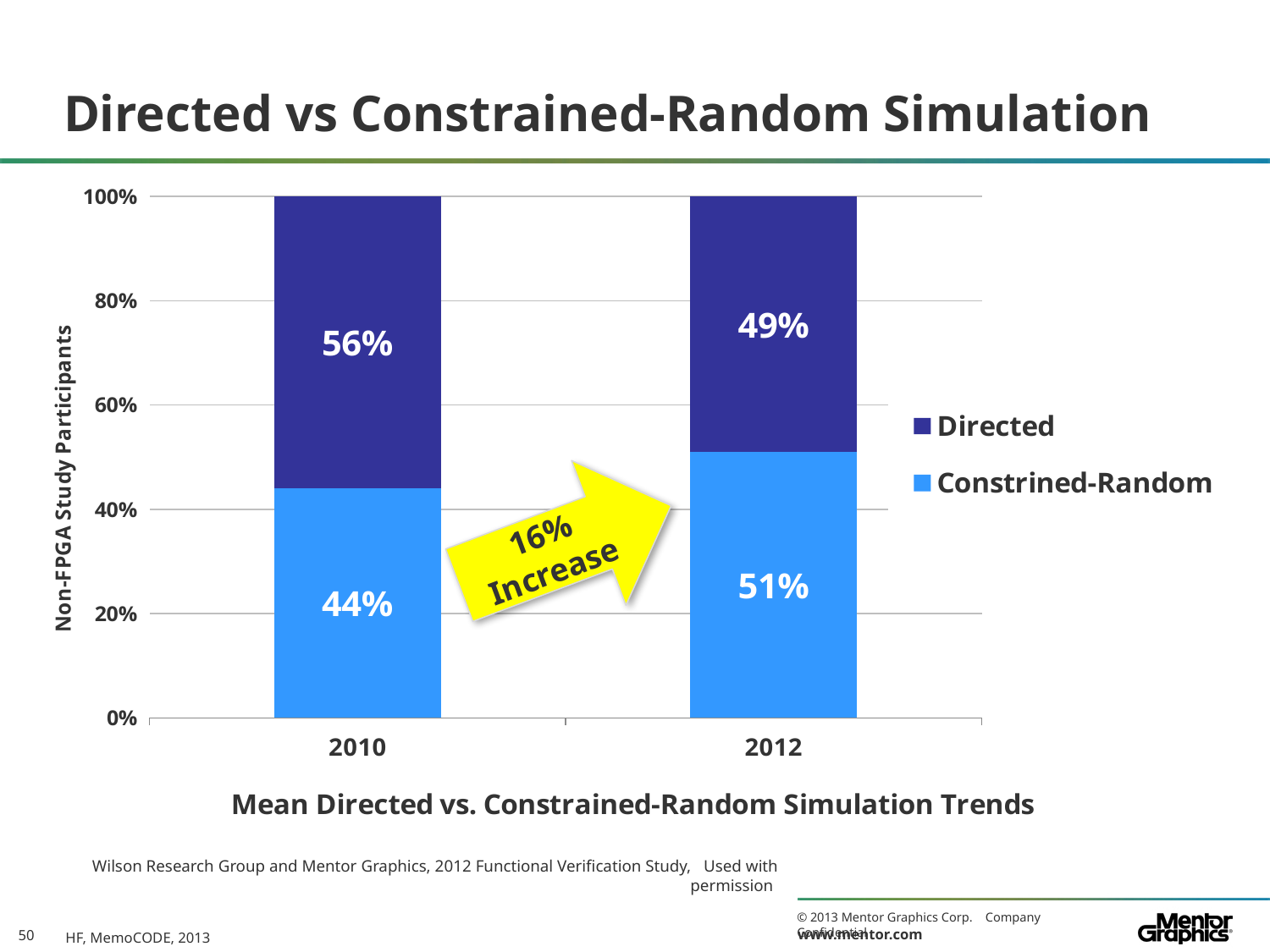
What is the difference between the Constrined-Random values for 2012 and 2010? 7% In which year is the Directed share higher? 2010 How many series does the legend list? 2 What is the Directed value for 2010? 56% What is the title of the chart? Mean Directed vs. Constrained-Random Simulation Trends What is the Constrined-Random value for 2012? 51% In which year is the Constrined-Random share higher? 2012 What is the difference between the Directed and Constrined-Random values in 2010? 12% What kind of chart is shown? Stacked bar chart What is the Constrined-Random value for 2010? 44% What is the Directed value for 2012? 49% How many years are shown on the x axis? 2